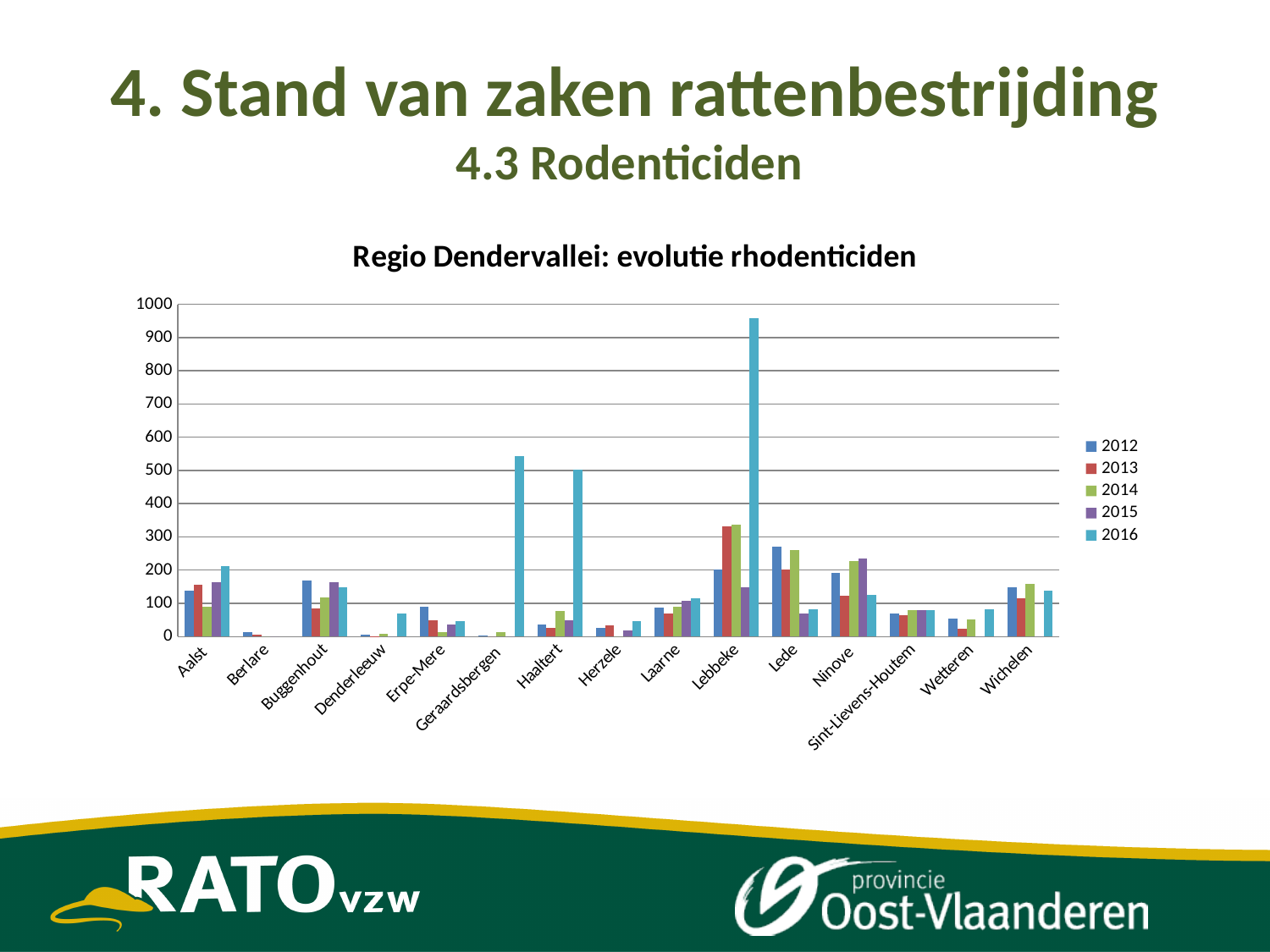
Which is larger for Ninove: the 2013 value or the 2014 value? 2014 What kind of chart is shown on the slide? bar chart Which is larger for Lede: the 2012 value or the 2013 value? 2012 How many municipalities (categories) are shown on the x axis? 15 Is the 2013 value for Lebbeke greater or less than 300? greater What is the title of the chart? Regio Dendervallei: evolutie rhodenticiden Which municipality has the highest value for 2012? Lede Is the 2016 value for Lebbeke greater or less than 900? greater How many series does the legend list? 5 Is the 2012 value for Lede greater or less than 300? less Which municipality has the highest value for 2016? Lebbeke